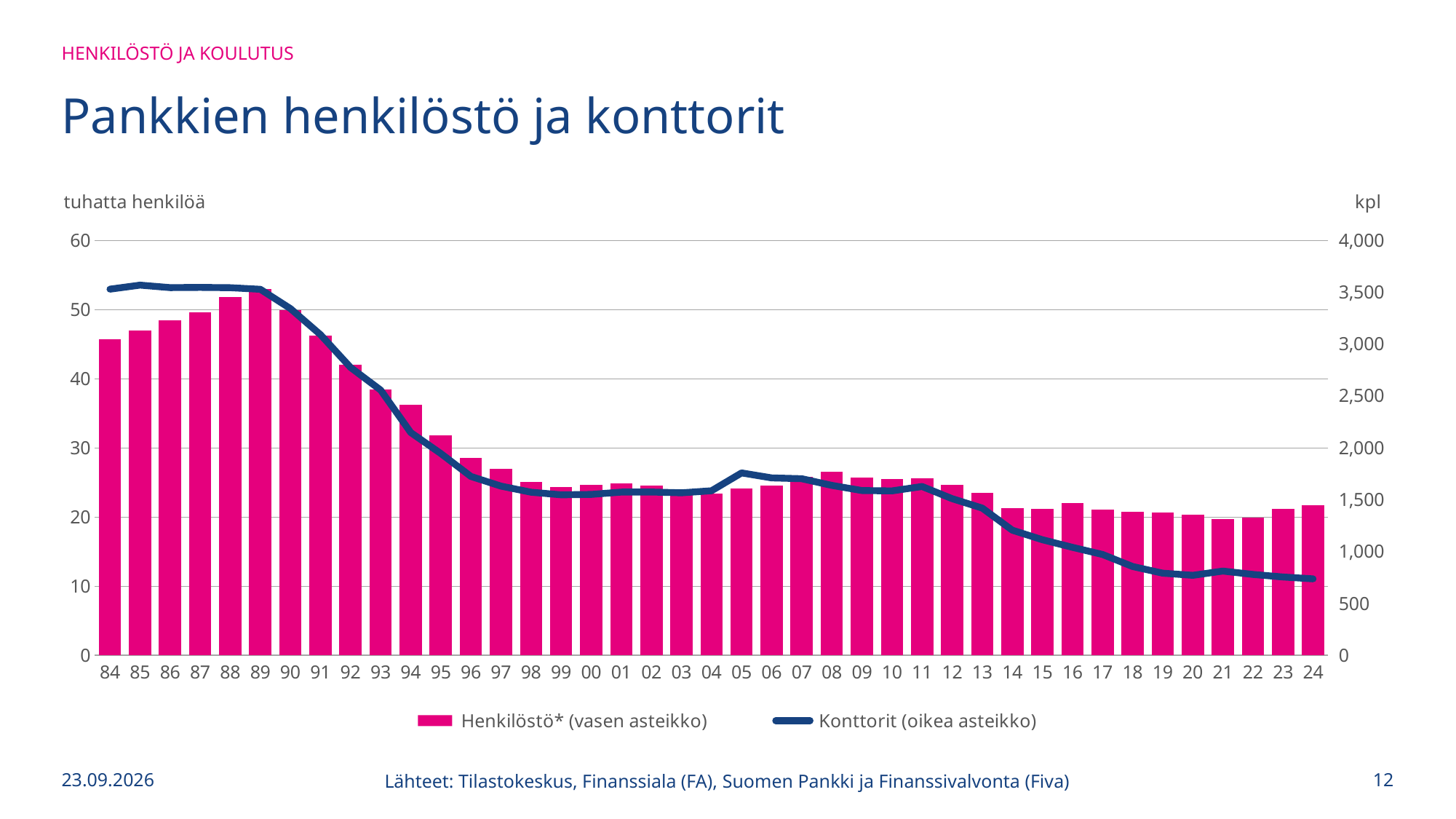
Which year has the highest Henkilöstö* bar? 89 How many years are shown on the x axis? 41 Does the Konttorit line rise or fall overall from 89 to 24? Fall Which has the larger Henkilöstö* bar, 88 or 91? 88 Is the Konttorit value for 24 greater or less than 1,000? less What unit is shown on the right-hand axis? kpl Is the Henkilöstö* value for 84 greater or less than 40? greater Is the Henkilöstö* value for 94 greater or less than 40? less How many series does the legend list? 2 What kind of chart is shown on the slide? Combined bar and line chart